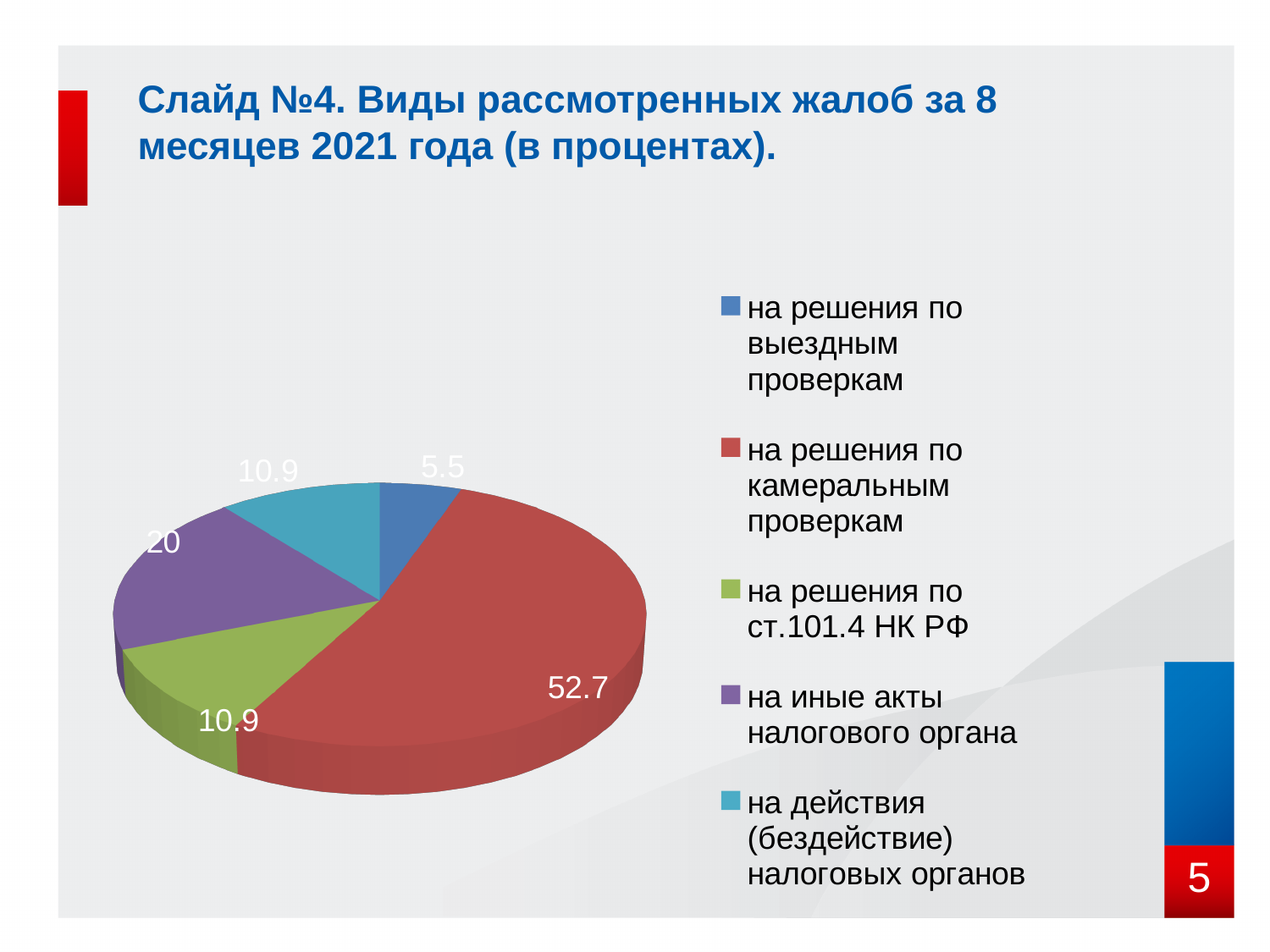
How many slices does the pie chart have? 5 How many entries does the legend list? 5 Which category has the smallest slice of the pie? на решения по выездным проверкам Which category has the largest slice of the pie? на решения по камеральным проверкам What kind of chart is shown on the slide? Pie chart What colour is the slice for "на решения по камеральным проверкам"? Red What is the value for "на иные акты налогового органа"? 20 What is the value for "на решения по камеральным проверкам"? 52.7 Which is larger: the value for "на иные акты налогового органа" or the value for "на действия (бездействие) налоговых органов"? на иные акты налогового органа What is the value for "на решения по ст.101.4 НК РФ"? 10.9 What is the value for "на решения по выездным проверкам"? 5.5 What is the difference between the values for "на решения по камеральным проверкам" and "на иные акты налогового органа"? 32.7